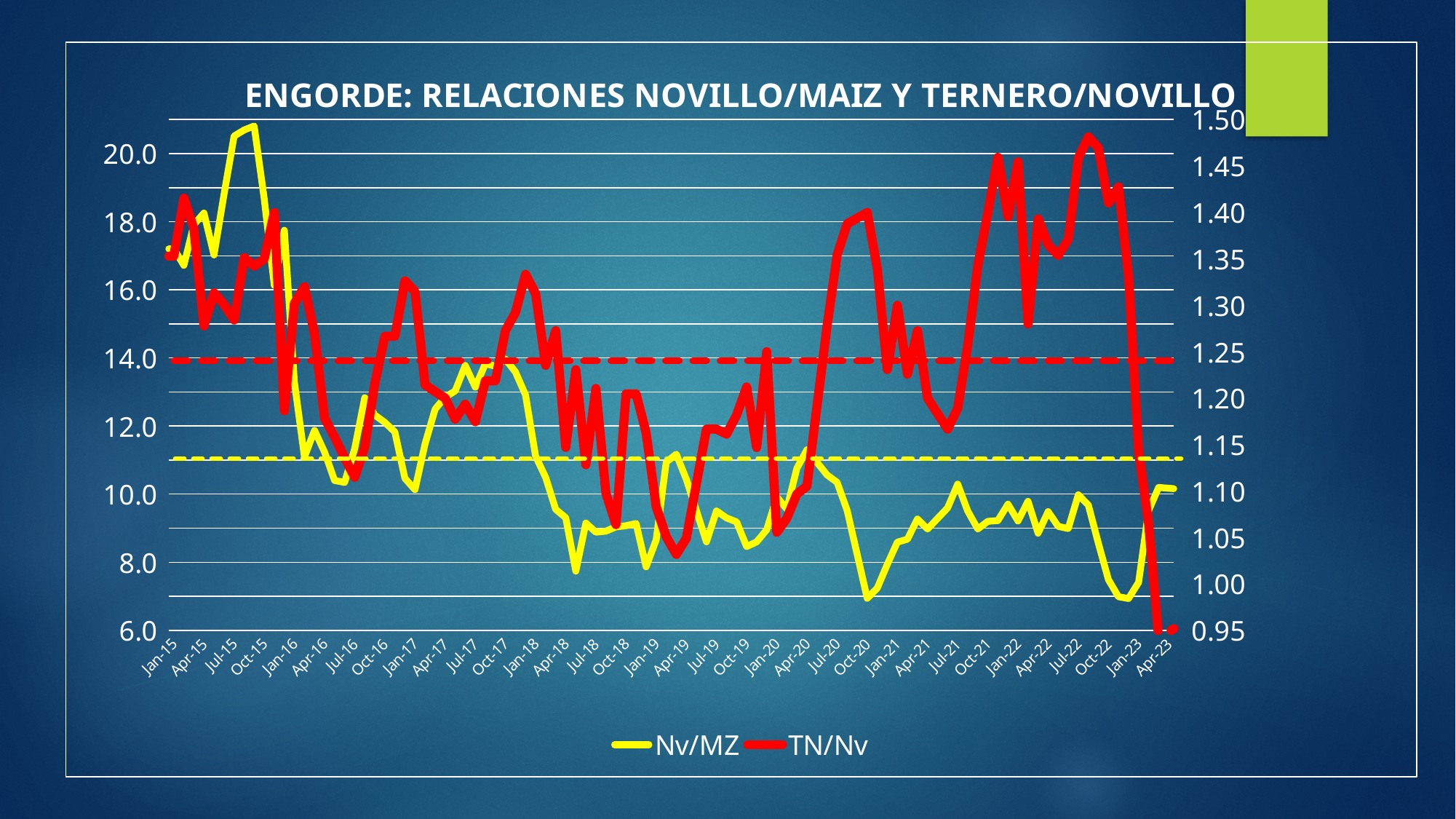
At which x-axis label does the TN/Nv series reach its lowest value? Apr-23 Is the highest value of the Nv/MZ series greater or less than 20.0? greater What is the title of the chart? ENGORDE: RELACIONES NOVILLO/MAIZ Y TERNERO/NOVILLO In which year does the Nv/MZ series reach its highest value? 2015 Overall, does the Nv/MZ series rise or fall from Jan-15 to Apr-23? fall Is the value of TN/Nv at Apr-23 greater or less than 1.00? less Is the value of Nv/MZ at Apr-23 greater or less than 12.0? less What are the two series named in the legend? Nv/MZ and TN/Nv What kind of chart is shown on the slide? line chart How many series does the legend list? 2